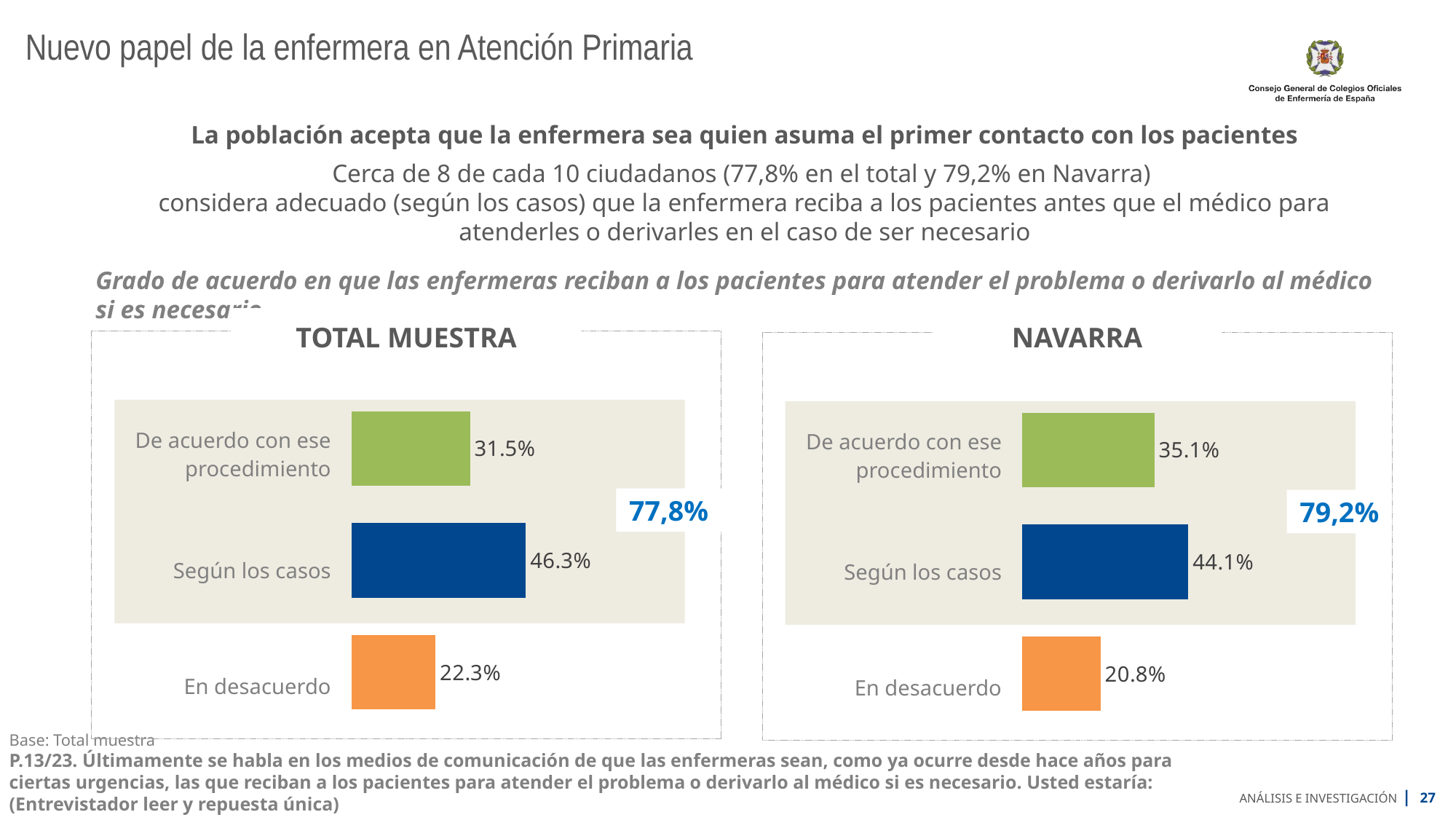
How many categories does the TOTAL MUESTRA chart show? 3 In the NAVARRA chart, what colour is the bar for "En desacuerdo"? Orange What type of chart is the NAVARRA chart? Bar chart In the TOTAL MUESTRA chart, what is the difference between "Según los casos" and "De acuerdo con ese procedimiento"? 14.8 percentage points In the NAVARRA chart, what is the difference between "Según los casos" and "En desacuerdo"? 23.3 percentage points In the NAVARRA chart, which category has the lowest value? En desacuerdo In the NAVARRA chart, what is the value for "En desacuerdo"? 20.8% In the TOTAL MUESTRA chart, what is the value for "Según los casos"? 46.3% In the TOTAL MUESTRA chart, which category has the highest value? Según los casos Which is larger: "De acuerdo con ese procedimiento" in the TOTAL MUESTRA chart or in the NAVARRA chart? NAVARRA In the TOTAL MUESTRA chart, what combined figure is highlighted for the first two categories? 77,8% In the NAVARRA chart, what is the value for "De acuerdo con ese procedimiento"? 35.1%